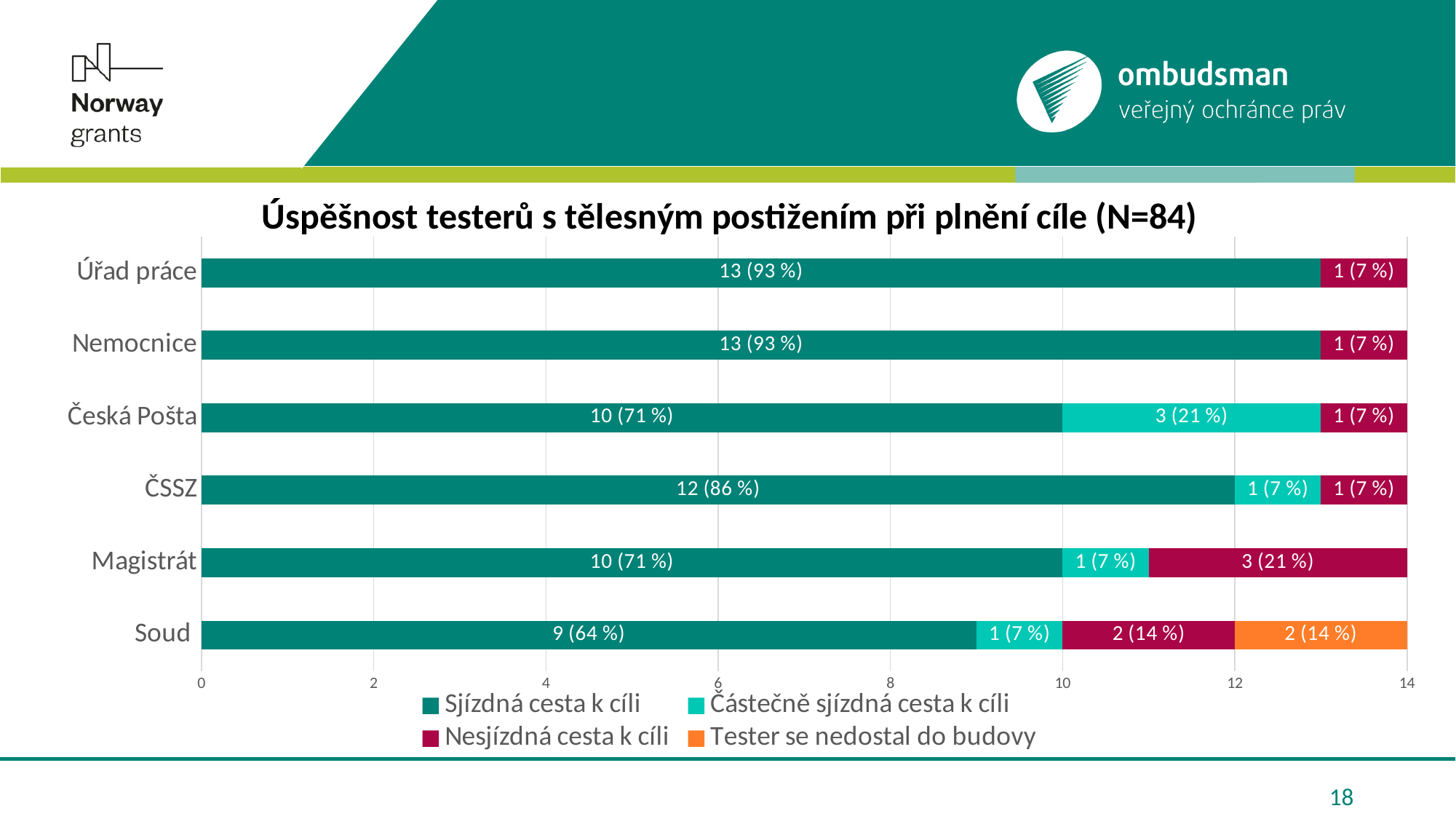
What is the title of the chart? Úspěšnost testerů s tělesným postižením při plnění cíle (N=84) What kind of chart is shown on the slide? Stacked bar chart How many series does the legend list? 4 What is the value of 'Nesjízdná cesta k cíli' for Magistrát? 3 (21 %) Which category has the lowest value for 'Sjízdná cesta k cíli'? Soud What is the difference between the 'Sjízdná cesta k cíli' values for Úřad práce and ČSSZ? 1 What is the value of 'Sjízdná cesta k cíli' for Soud? 9 (64 %) Which is larger: the 'Nesjízdná cesta k cíli' value for Magistrát or for Soud? Magistrát What is the value of 'Částečně sjízdná cesta k cíli' for Česká Pošta? 3 (21 %) How many categories are shown on the vertical axis of the chart? 6 What is the value of 'Tester se nedostal do budovy' for Soud? 2 (14 %) What is the total of the stacked bar for Česká Pošta? 14